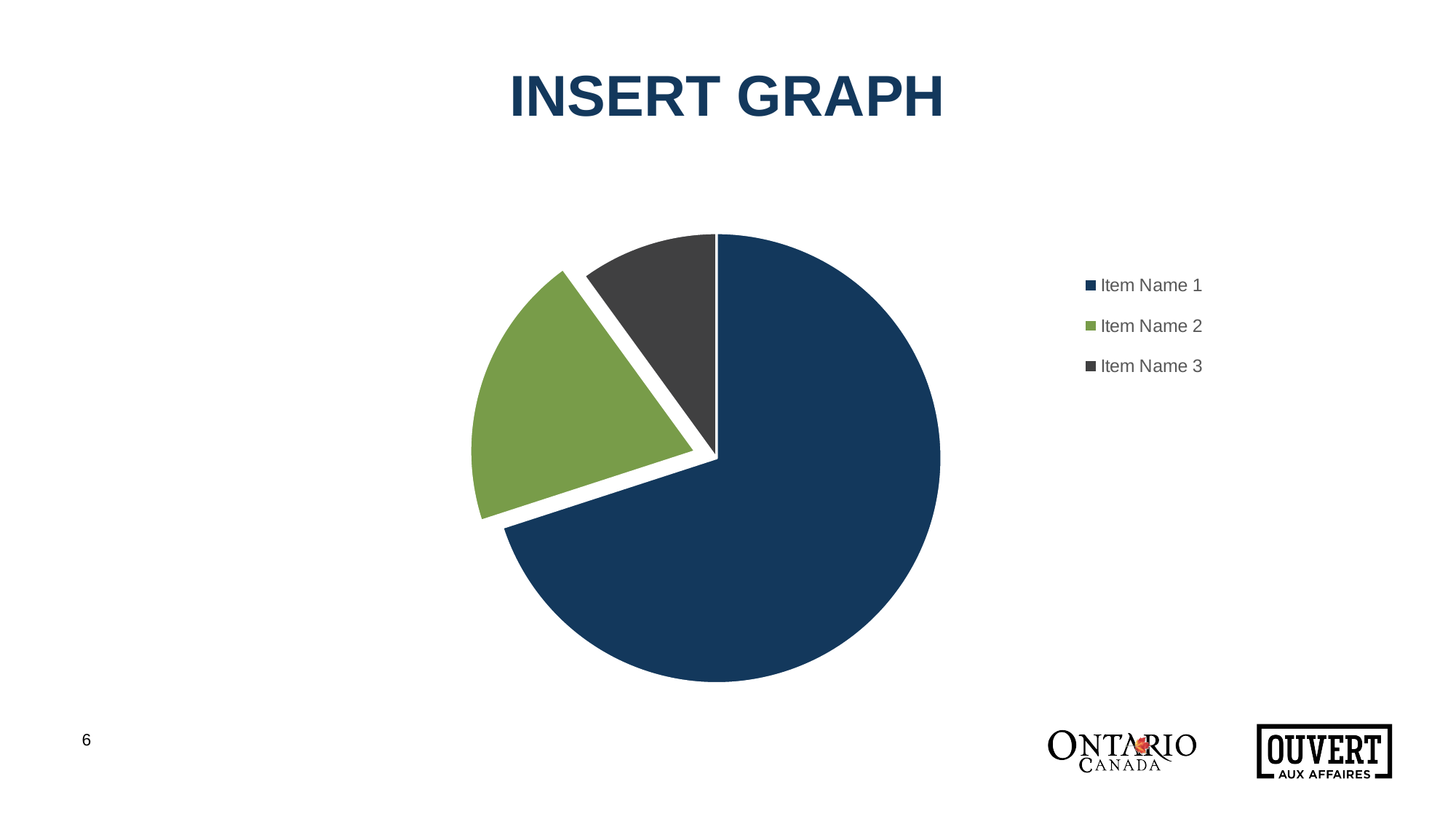
How many entries does the legend of the pie chart list? 3 Which slice of the pie chart is pulled out (exploded) from the rest? Item Name 2 Which item has the smallest slice of the pie chart? Item Name 3 Which slice is larger, Item Name 1 or Item Name 2? Item Name 1 What kind of chart is shown on the slide? Pie chart What colour is the slice for Item Name 1 in the pie chart? Dark blue Which item has the largest slice of the pie chart? Item Name 1 Does Item Name 1 take up more or less than half of the pie chart? More How many slices does the pie chart have? 3 Which slice is larger, Item Name 2 or Item Name 3? Item Name 2